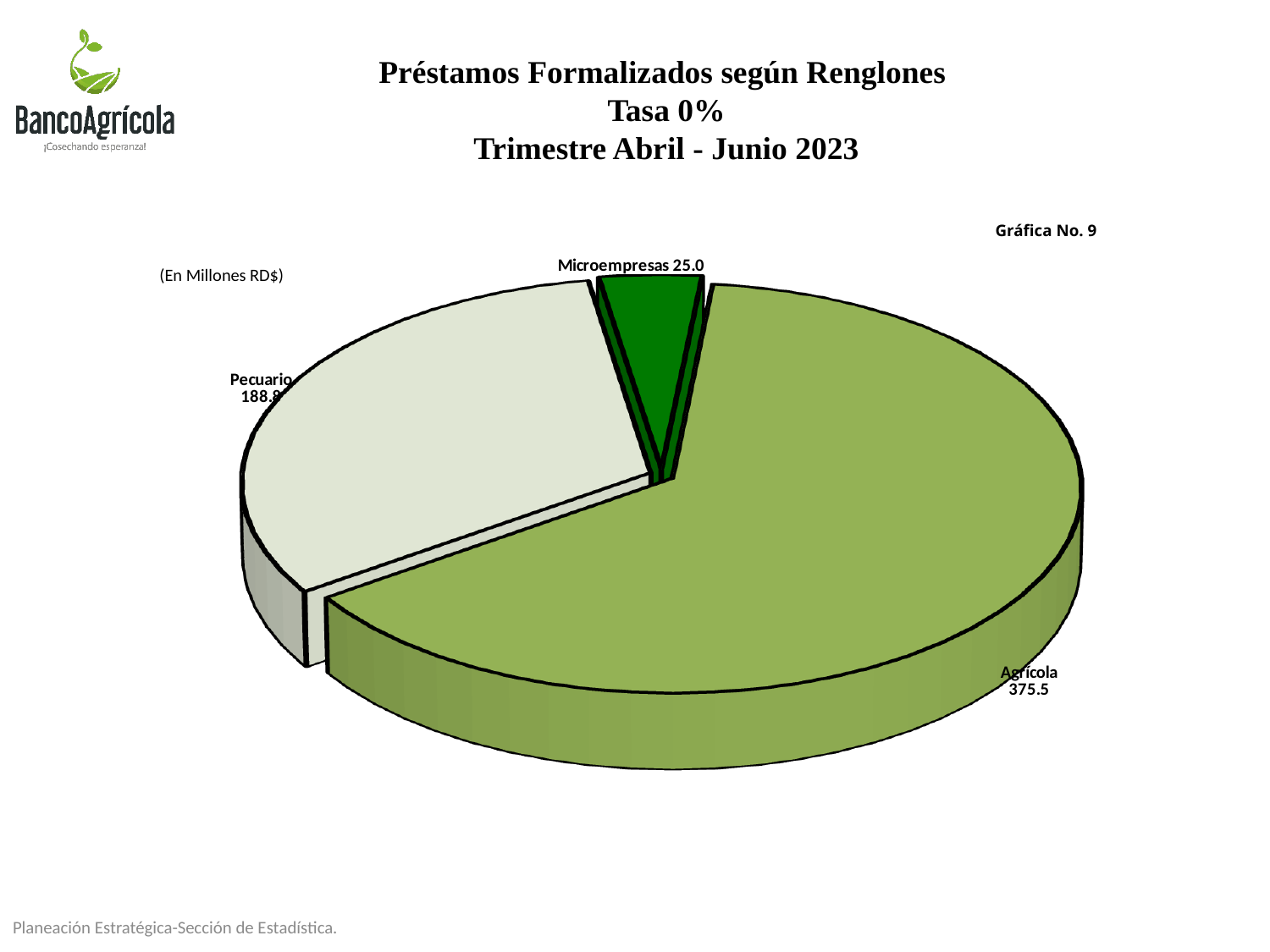
In what units are the values on the chart expressed, according to the note on the slide? En Millones RD$ What is the value shown for Agrícola? 375.5 Which category has the largest slice of the pie? Agrícola What is the difference between the values for Agrícola and Microempresas? 350.5 Which category has the smallest slice of the pie? Microempresas What graph number is given on the slide? Gráfica No. 9 What kind of chart is shown on the slide? pie chart How many slices does the pie chart have? 3 Which is larger, the value for Agrícola or the value for Pecuario? Agrícola Which is larger, the value for Pecuario or the value for Microempresas? Pecuario What is the value shown for Microempresas? 25.0